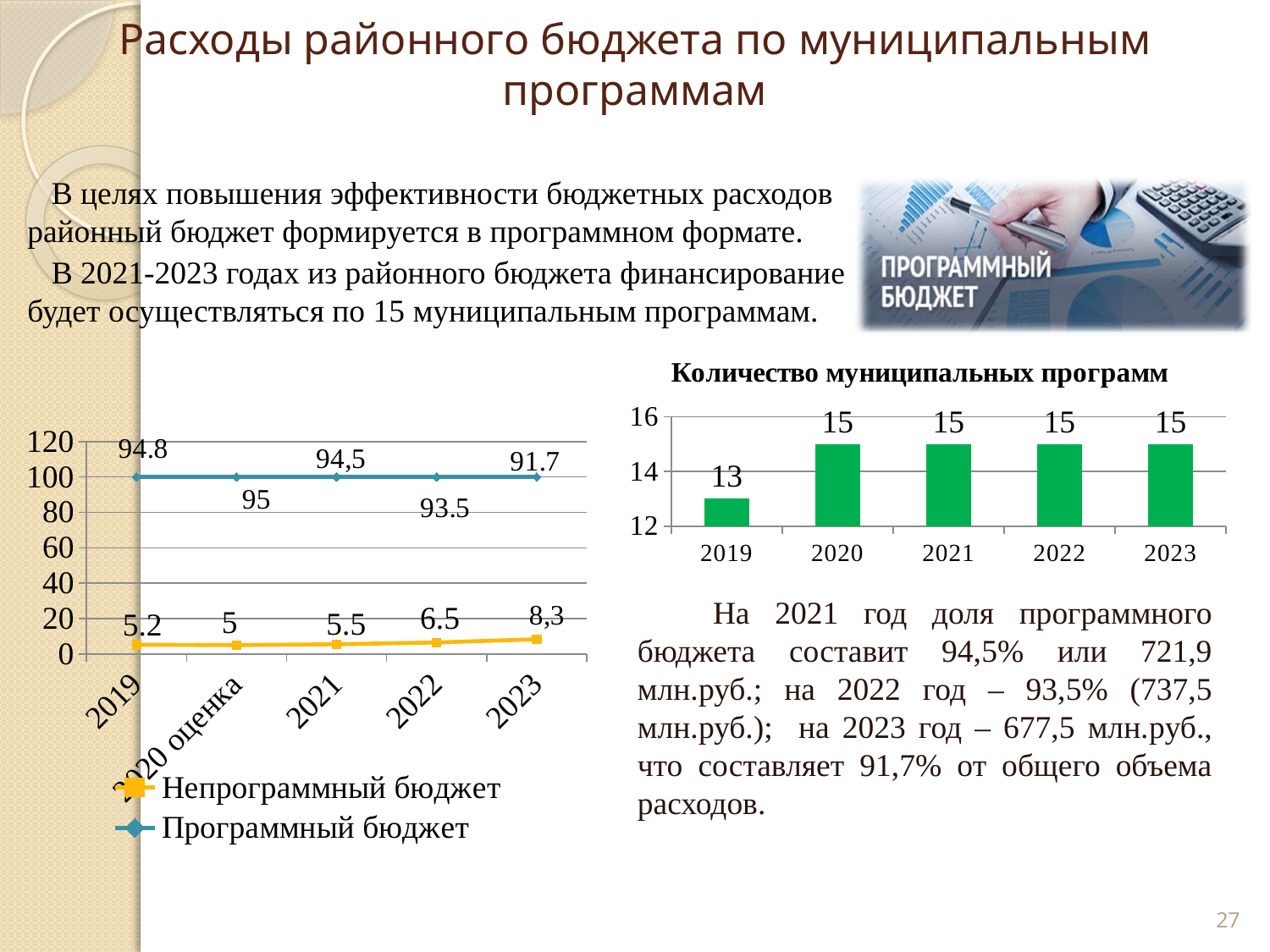
In the chart titled 'Количество муниципальных программ', which year has the lowest value? 2019 In the line chart on the left of the slide, which series has the larger value for 2021, 'Программный бюджет' or 'Непрограммный бюджет'? Программный бюджет In the line chart on the left of the slide, what is the value of 'Непрограммный бюджет' for 2023? 8,3 What kind of chart is the chart titled 'Количество муниципальных программ'? bar chart In the chart titled 'Количество муниципальных программ', what is the value for 2022? 15 In the chart titled 'Количество муниципальных программ', what is the value for 2019? 13 In the line chart on the left of the slide, what is the value of 'Непрограммный бюджет' for 2022? 6.5 In the line chart on the left of the slide, how many series does the legend list? 2 In the line chart on the left of the slide, does the 'Непрограммный бюджет' series rise or fall from 2021 to 2023? rise In the chart titled 'Количество муниципальных программ', how many years are shown on the x axis? 5 In the line chart on the left of the slide, what is the value of 'Программный бюджет' for 2019? 94.8 In the chart titled 'Количество муниципальных программ', what is the difference between the values for 2020 and 2019? 2